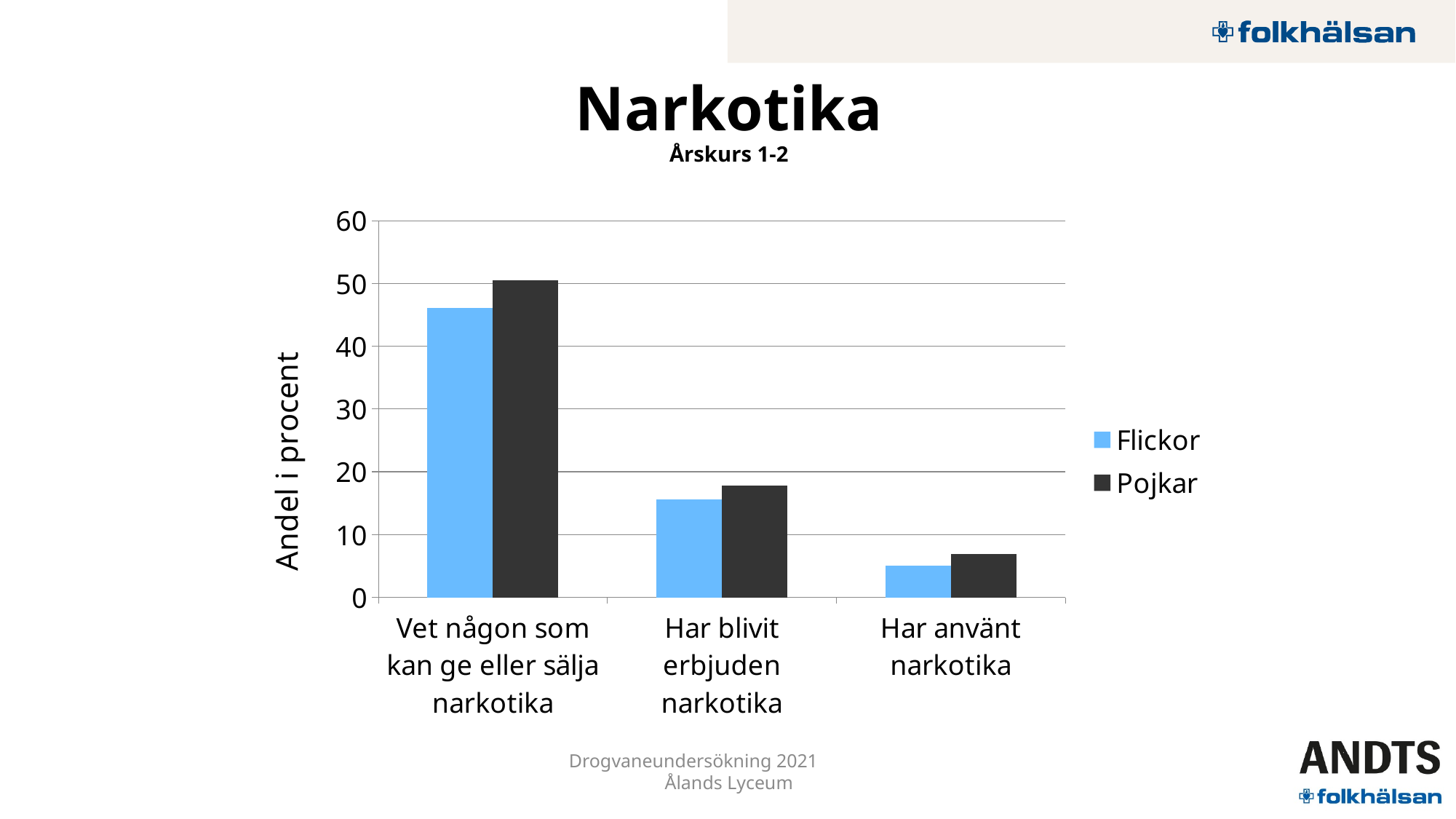
How many series does the legend list? 2 For 'Vet någon som kan ge eller sälja narkotika', which is larger, Flickor or Pojkar? Pojkar Which category has the highest values for both Flickor and Pojkar? Vet någon som kan ge eller sälja narkotika How many categories are shown on the x axis? 3 Which category has the lowest values for both Flickor and Pojkar? Har använt narkotika What kind of chart is shown on the slide? bar chart Is the Flickor value for 'Har använt narkotika' greater or less than 10? less For 'Har använt narkotika', which is larger, Flickor or Pojkar? Pojkar Is the Flickor value for 'Vet någon som kan ge eller sälja narkotika' greater or less than 40? greater What is the title of the vertical axis? Andel i procent Is the Pojkar value for 'Har blivit erbjuden narkotika' greater or less than 20? less Do the Pojkar values rise or fall from left to right along the x axis? fall